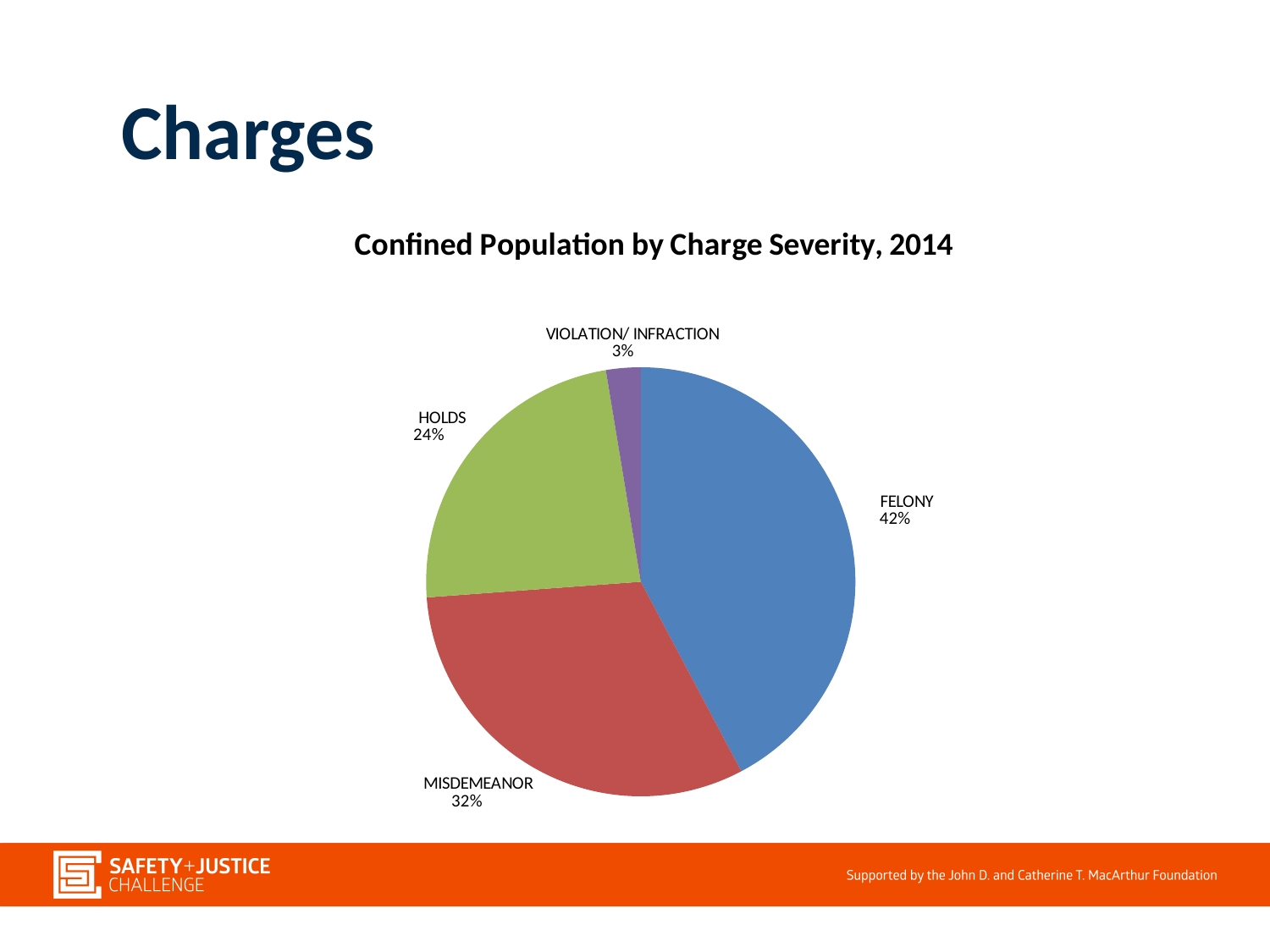
Which category has the smallest share of the pie? VIOLATION/ INFRACTION What is the difference in percentage points between FELONY and MISDEMEANOR? 10 What share of the confined population is FELONY? 42% Which is larger, the share for HOLDS or the share for MISDEMEANOR? MISDEMEANOR What share of the confined population is HOLDS? 24% What is the title of the chart? Confined Population by Charge Severity, 2014 How many categories are shown in the pie chart? 4 What share of the confined population is VIOLATION/ INFRACTION? 3% What share of the confined population is MISDEMEANOR? 32% What colour is the FELONY slice? blue Which category has the largest share of the pie? FELONY What type of chart is shown on the slide? pie chart